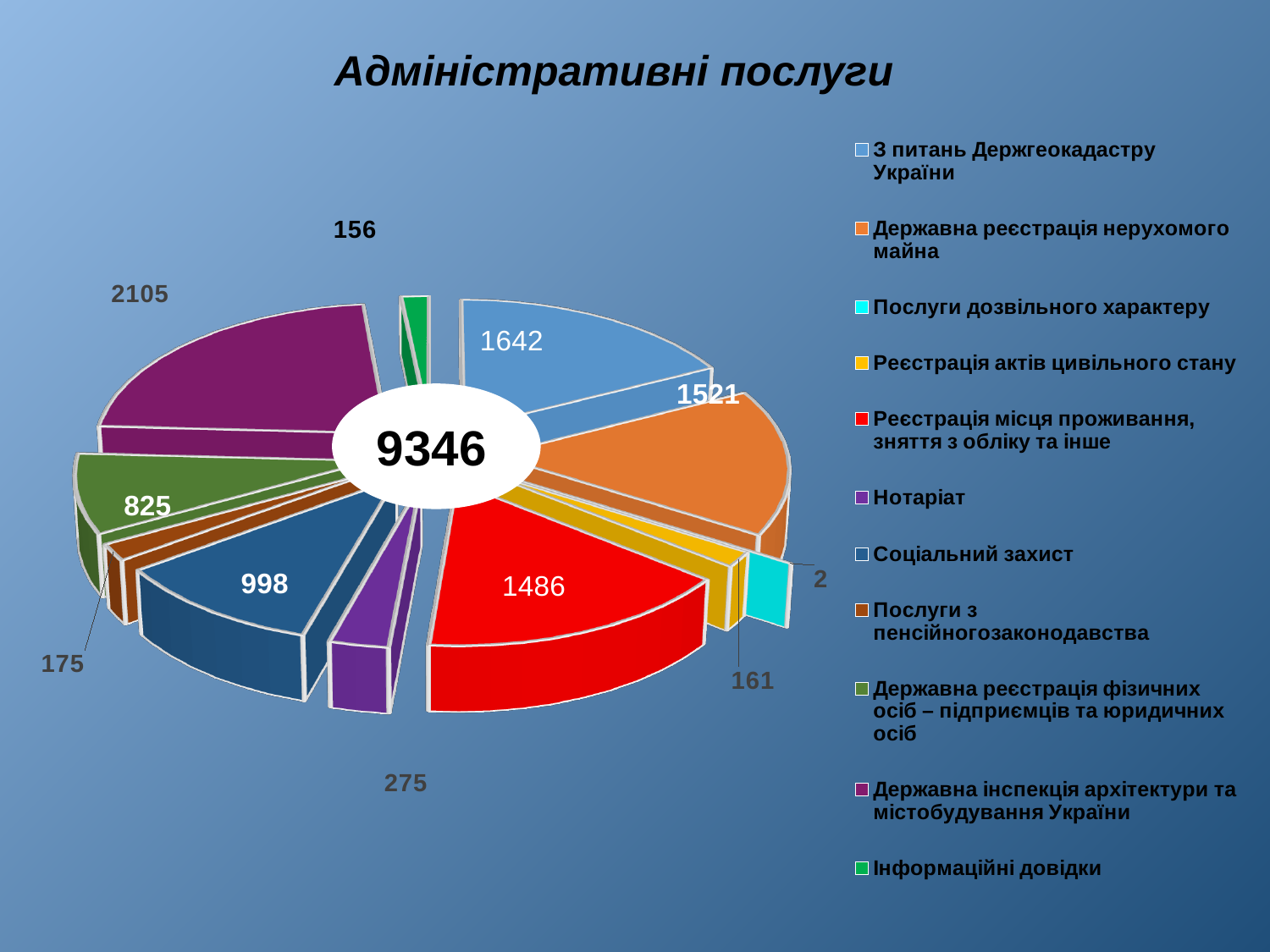
What is the total value shown in the centre of the pie chart? 9346 What is the title of the chart? Адміністративні послуги What kind of chart is shown on the slide? pie chart What is the difference between the values for 'Державна реєстрація нерухомого майна' and 'Реєстрація актів цивільного стану'? 1360 Which category has the smallest value in the pie chart? Послуги дозвільного характеру Which is larger: the value for 'Державна реєстрація фізичних осіб – підприємців та юридичних осіб' or the value for 'Інформаційні довідки'? Державна реєстрація фізичних осіб – підприємців та юридичних осіб Which category has the largest value in the pie chart? Державна інспекція архітектури та містобудування України What is the value for 'Нотаріат'? 275 What is the value for 'Соціальний захист'? 998 What is the value for 'З питань Держгеокадастру України'? 1642 How many categories does the legend of the pie chart list? 11 What is the value for 'Реєстрація місця проживання, зняття з обліку та інше'? 1486